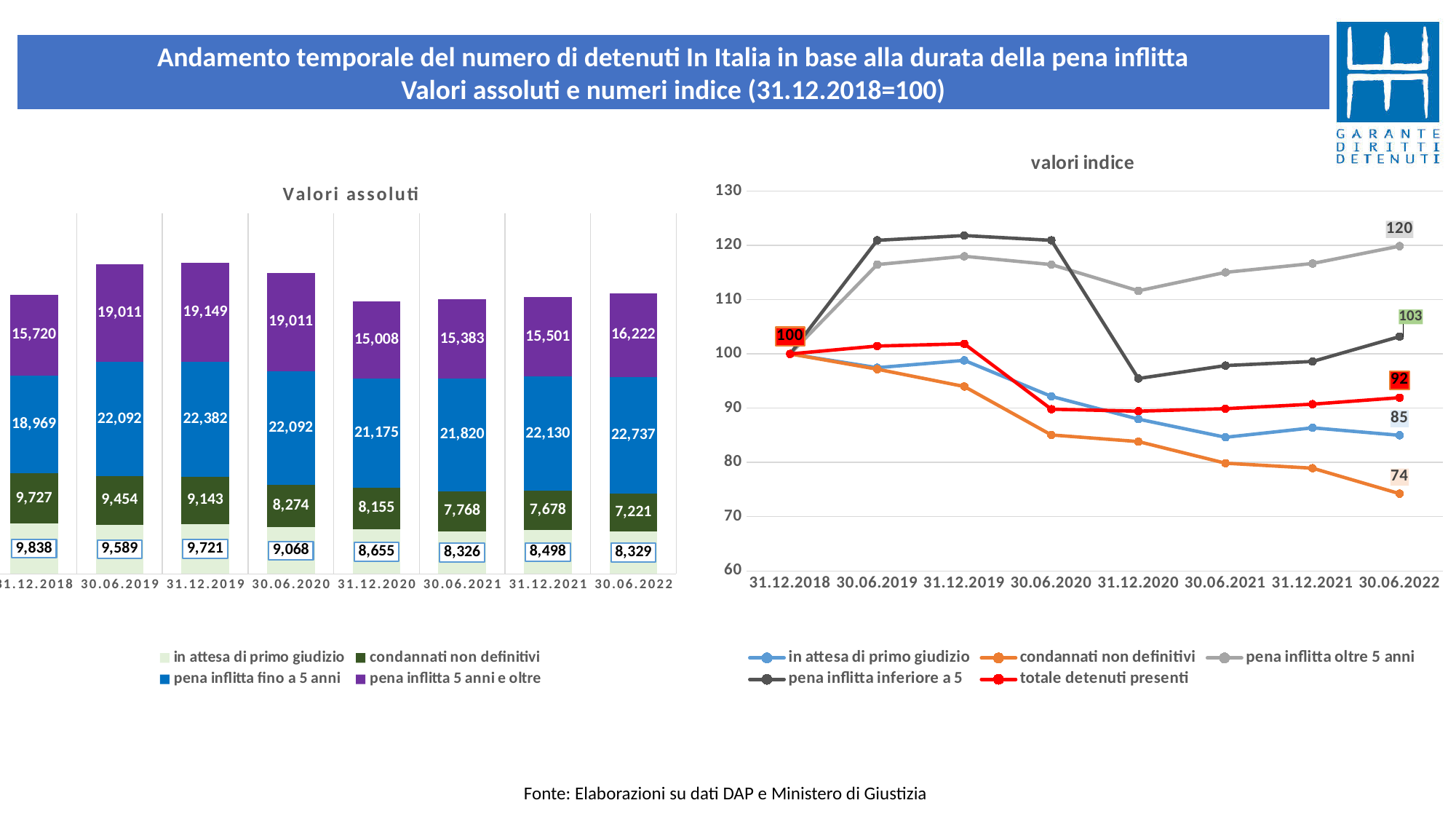
In the valori indice chart, what is the value for pena inflitta oltre 5 anni at 30.06.2022? 120 In the Valori assoluti chart, what is the value for condannati non definitivi at 30.06.2022? 7,221 What kind of chart is the Valori assoluti chart? Stacked bar chart In the Valori assoluti chart, what is the value for pena inflitta 5 anni e oltre at 30.06.2019? 19,011 In the Valori assoluti chart, at which date is the value for condannati non definitivi lowest? 30.06.2022 How many series does the legend of the valori indice chart list? 5 In the valori indice chart, does the condannati non definitivi line rise or fall from 31.12.2018 to 30.06.2022? Fall In the Valori assoluti chart, at which date is the value for in attesa di primo giudizio highest? 31.12.2018 In the Valori assoluti chart, which is larger: in attesa di primo giudizio at 31.12.2019 or at 30.06.2020? 31.12.2019 In the Valori assoluti chart, what is the difference between the pena inflitta fino a 5 anni values at 30.06.2022 and 31.12.2018? 3,768 In the valori indice chart, is the value for pena inflitta inferiore a 5 at 31.12.2019 greater or less than 120? greater In the Valori assoluti chart, what is the total of the stacked bar for 31.12.2018? 54,254